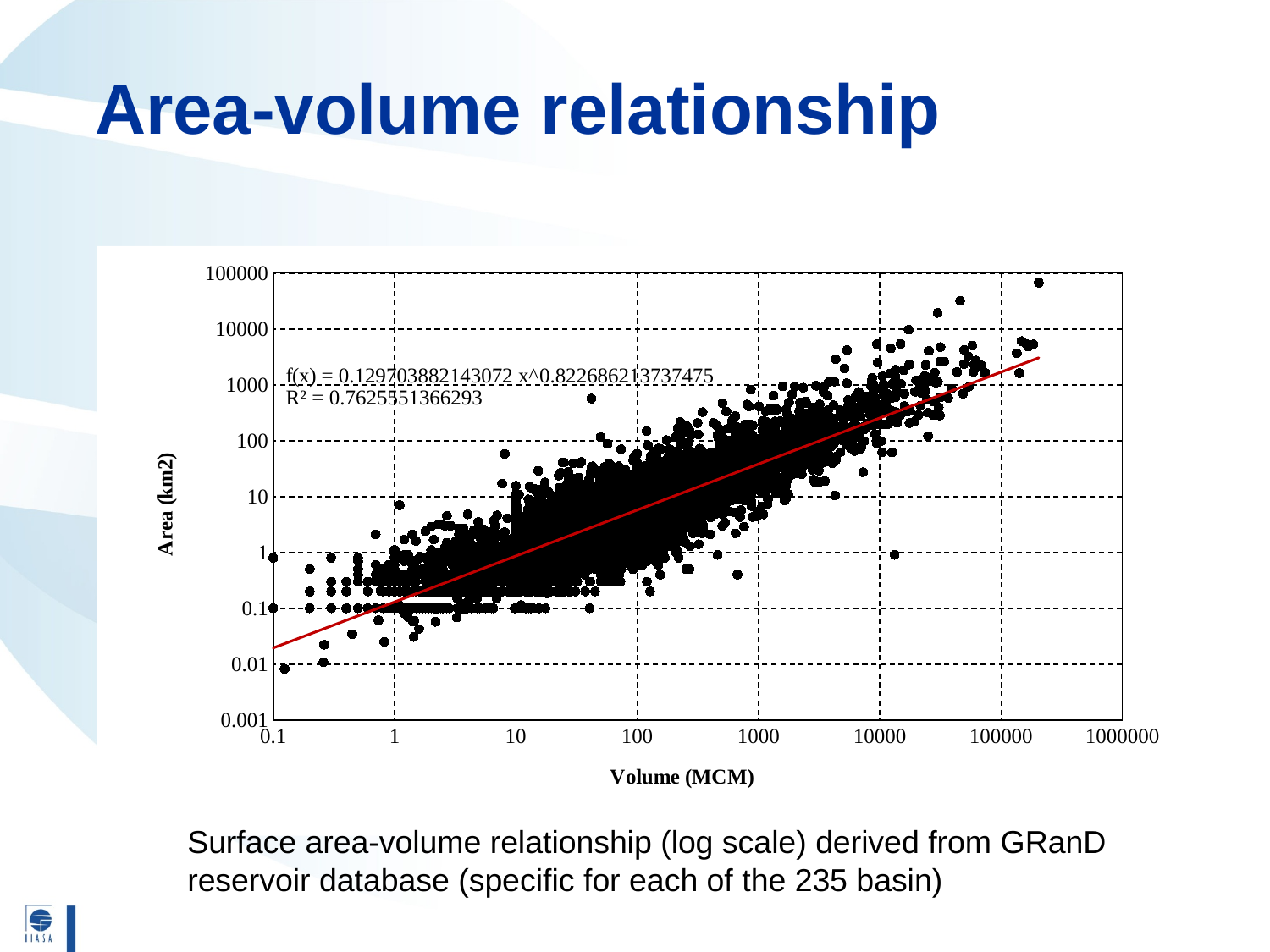
What is the R² value printed on the chart? 0.7625551366293 Is the area of the highest plotted point greater or less than 10000? greater What is the coefficient multiplying x^0.822686213737475 in the fitted equation printed on the chart? 0.129703882143072 What kind of chart is shown on the slide? scatter chart What is the exponent of x in the fitted equation f(x) printed on the chart? 0.822686213737475 Is the volume of the rightmost plotted point greater or less than 100000? greater What is the label of the y axis? Area (km2) Do the plotted area values generally rise or fall as volume increases along the x axis? rise What is the label of the x axis? Volume (MCM)